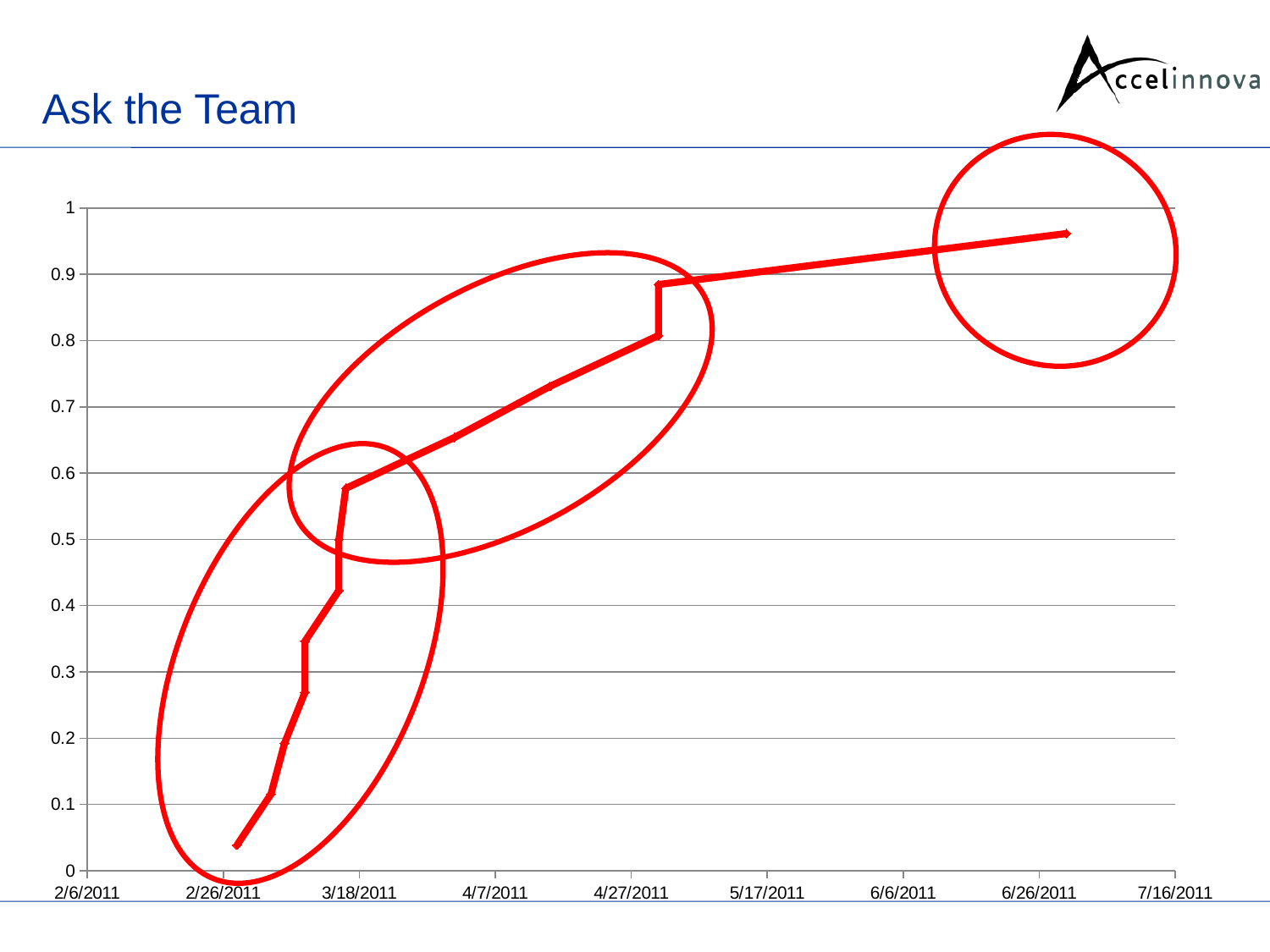
How many date labels are shown along the x axis? 9 What is the last date label on the x axis? 7/16/2011 What is the highest value shown on the y axis? 1 What is the first date label on the x axis? 2/6/2011 What kind of chart is shown on the slide? line chart Is the value of the point just after 4/27/2011, at the top of the vertical jump, greater or less than 0.8? greater What is the title of the slide containing the chart? Ask the Team Is the value of the point just before 3/18/2011, at the top of the vertical segment, greater or less than 0.5? greater Is the value of the first point on the line (just after 2/26/2011) greater or less than 0.1? less Do the plotted values rise or fall as the dates move from left to right along the x axis? rise